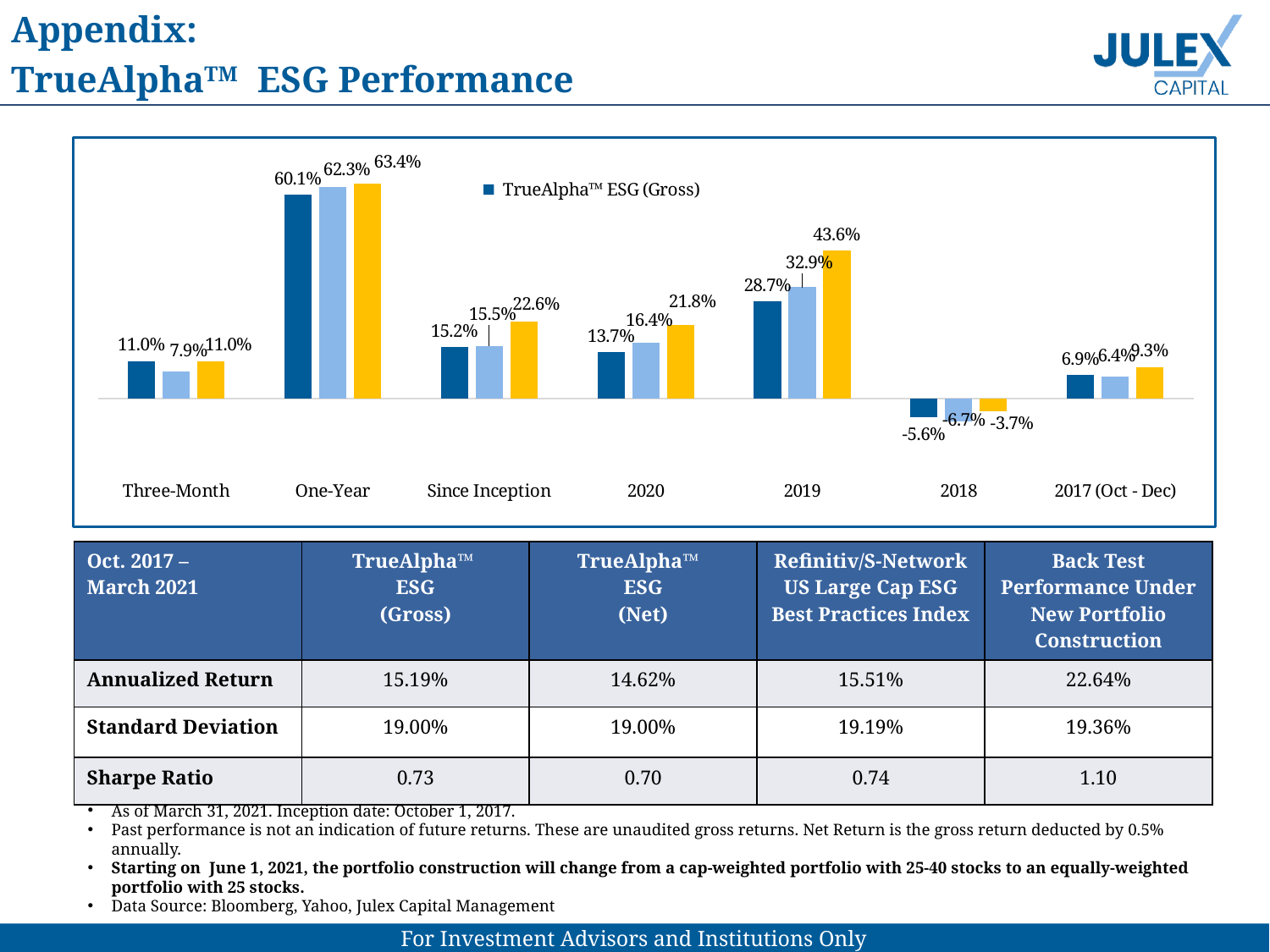
What kind of chart is shown on the slide? Bar chart What is the TrueAlpha ESG (Gross) value for Since Inception? 15.2% How many series does the chart legend list? 1 What is the difference between the TrueAlpha ESG (Gross) values for 2019 and 2020? 15.0% Which category has the highest TrueAlpha ESG (Gross) value? One-Year How many categories are shown on the x axis of the chart? 7 What is the TrueAlpha ESG (Gross) value for 2019? 28.7% Which category has the lowest TrueAlpha ESG (Gross) value? 2018 Is the TrueAlpha ESG (Gross) value larger for 2020 or for 2017 (Oct - Dec)? 2020 What is the TrueAlpha ESG (Gross) value for One-Year? 60.1% What is the TrueAlpha ESG (Gross) value for 2018? -5.6% What is the series name shown in the chart legend? TrueAlpha™ ESG (Gross)